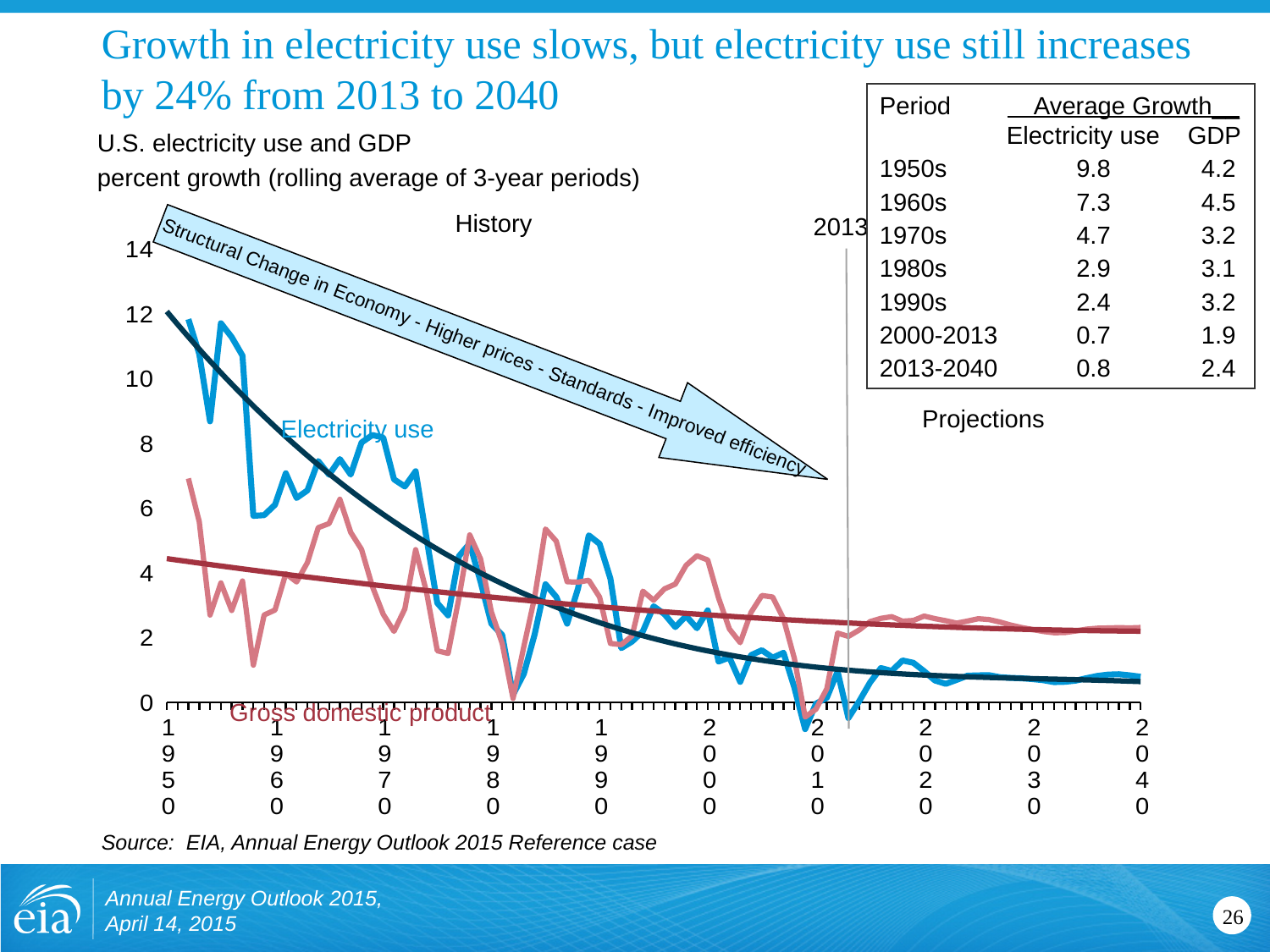
In the Average Growth table, what is the electricity use growth for the 1950s? 9.8 Does the Electricity use line generally rise or fall from 1950 to 2040? fall Is the Electricity use value at the start of the chart (1950) greater or less than 10? greater In the Average Growth table, which period has the lowest electricity use growth? 2000-2013 In the Average Growth table, what is the GDP growth for 2013-2040? 2.4 Which two series are plotted as lines in the chart? Electricity use and Gross domestic product In the Average Growth table, which is larger for the 1990s: electricity use growth or GDP growth? GDP What kind of chart is shown on the slide? line chart In the Average Growth table, what is the difference between electricity use growth and GDP growth in the 1950s? 5.6 How many periods are listed in the Average Growth table? 7 In the Average Growth table, which period has the highest GDP growth? 1960s Is the Gross domestic product value at the start of the chart (1950) greater or less than 10? less